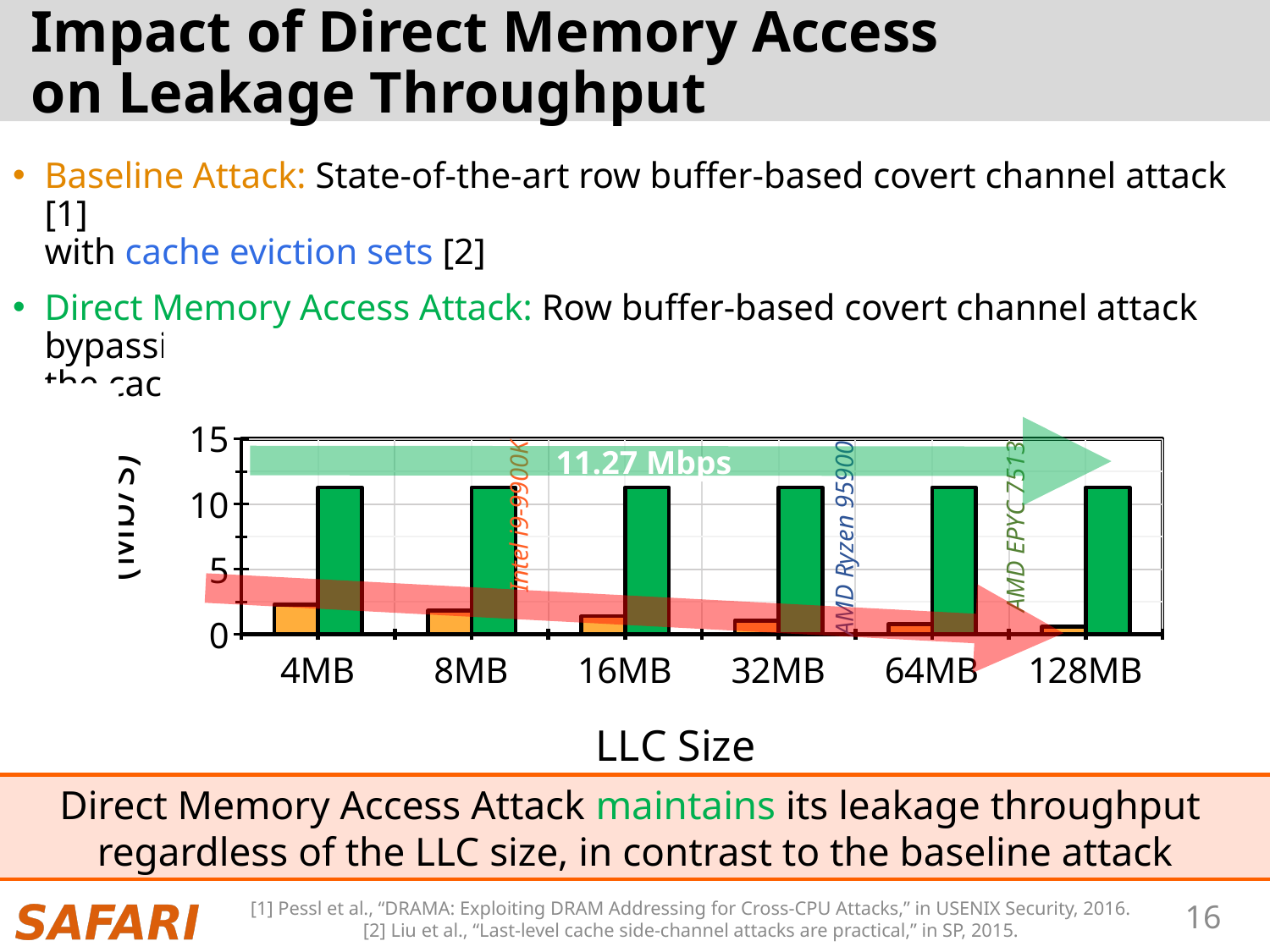
How many LLC size categories are shown on the x axis? 6 Is the value of the orange bar at 4MB greater or less than 5? less What is the title of the x axis? LLC Size Do the orange bars rise or fall as the LLC size increases along the x axis? fall Among the orange bars, which LLC size has the lowest value? 128MB Is the value of the orange bar at 128MB greater or less than 5? less What kind of chart is shown on the slide? bar chart What throughput value is annotated above the green bars? 11.27 Mbps At 4MB, which bar is larger, the orange bar or the green bar? green bar Among the orange bars, which LLC size has the highest value? 4MB Is the value of the green bar at 128MB greater or less than 5? greater